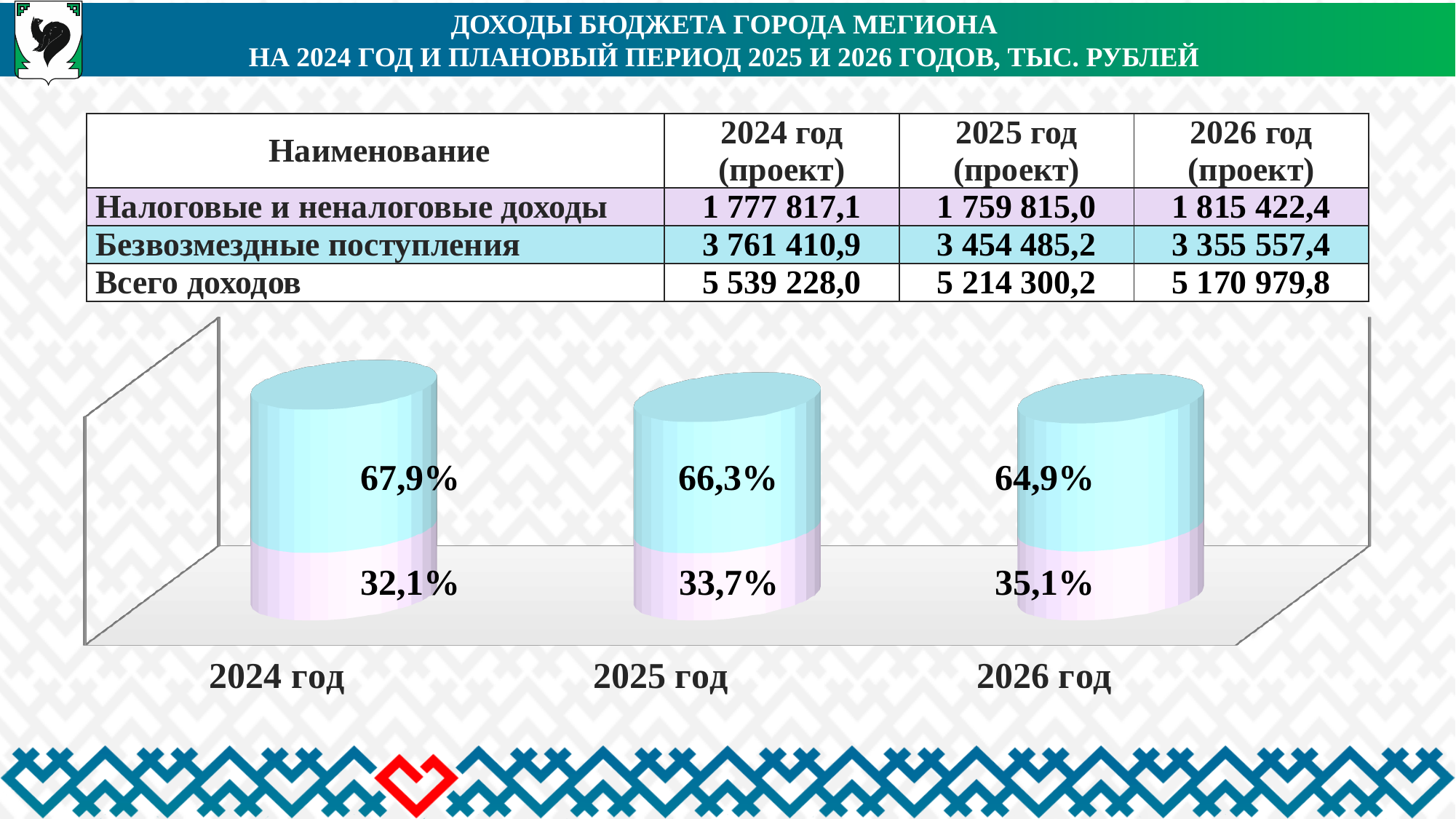
What is the value of the lower (pink) segment of the bar for 2025 год? 33,7% What kind of chart is shown on the slide? bar chart How many categories (years) are shown on the x axis of the chart? 3 What is the value of the upper (light blue) segment of the bar for 2026 год? 64,9% What is the value of the lower (pink) segment of the bar for 2024 год? 32,1% In which year is the lower (pink) segment the largest? 2026 год Which is larger: the lower (pink) segment for 2025 год or for 2026 год? 2026 год What is the value of the upper (light blue) segment of the bar for 2024 год? 67,9% In which year is the upper (light blue) segment the smallest? 2026 год What is the total of the two segments of the bar for 2025 год? 100% What is the difference between the upper (light blue) segment values for 2024 год and 2026 год? 3,0 percentage points How does the value of the lower (pink) segment change from 2024 год to 2026 год? It rises